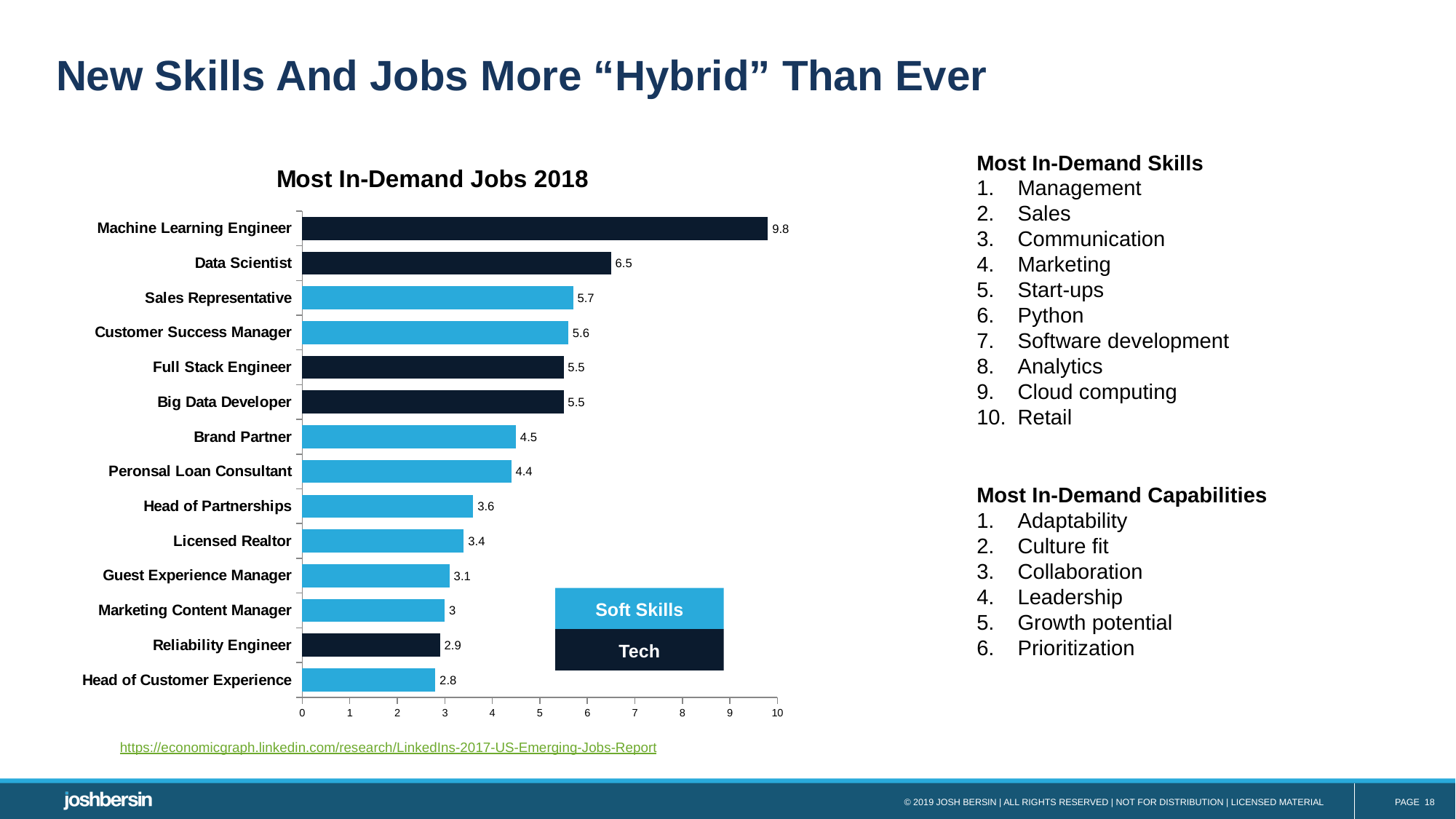
How many jobs are shown in the chart? 14 What is the value for Machine Learning Engineer in the Most In-Demand Jobs 2018 chart? 9.8 What are the two categories shown in the chart's legend? Soft Skills and Tech What is the difference between the values for Machine Learning Engineer and Data Scientist? 3.3 What is the value for Customer Success Manager? 5.6 What is the value for Head of Partnerships? 3.6 What kind of chart is shown on the slide? Bar chart Which job has the highest value in the chart? Machine Learning Engineer Which job has the lowest value in the chart? Head of Customer Experience What is the difference between the values for Sales Representative and Licensed Realtor? 2.3 Is the value for Data Scientist greater or less than 6? greater Which has a larger value, Brand Partner or Reliability Engineer? Brand Partner